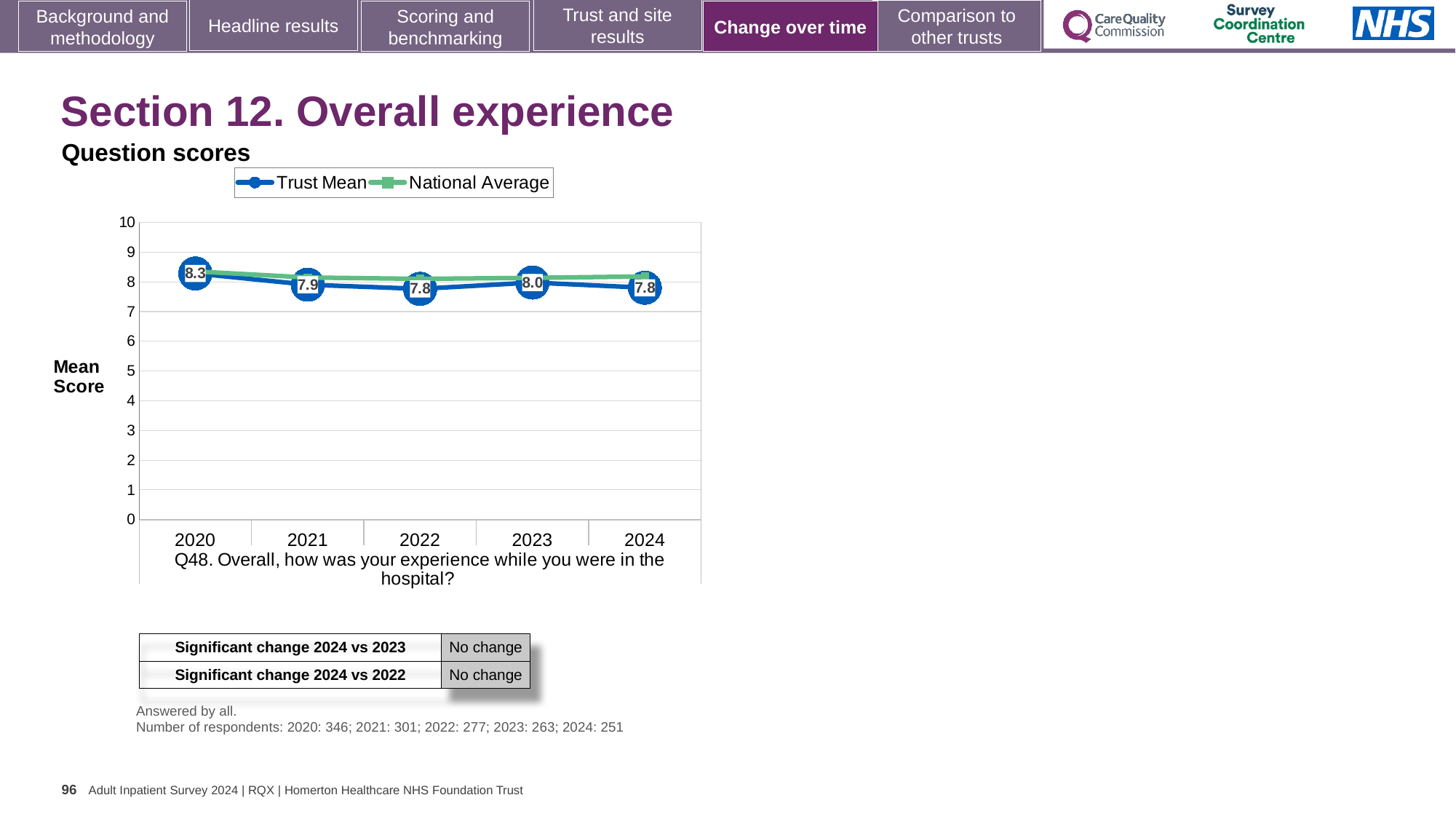
Is the National Average value for 2024 greater or less than 7? greater What is the Trust Mean score for 2024? 7.8 What is the Trust Mean score for 2023? 8.0 What is the label of the y axis? Mean Score Which is larger, the Trust Mean score in 2021 or in 2023? 2023 How many years are shown on the x axis? 5 What is the difference between the Trust Mean score in 2020 and in 2024? 0.5 What kind of chart is shown? line chart What is the Trust Mean score for 2020? 8.3 In which year is the Trust Mean score highest? 2020 What is the Trust Mean score for 2022? 7.8 How many series does the legend list? 2